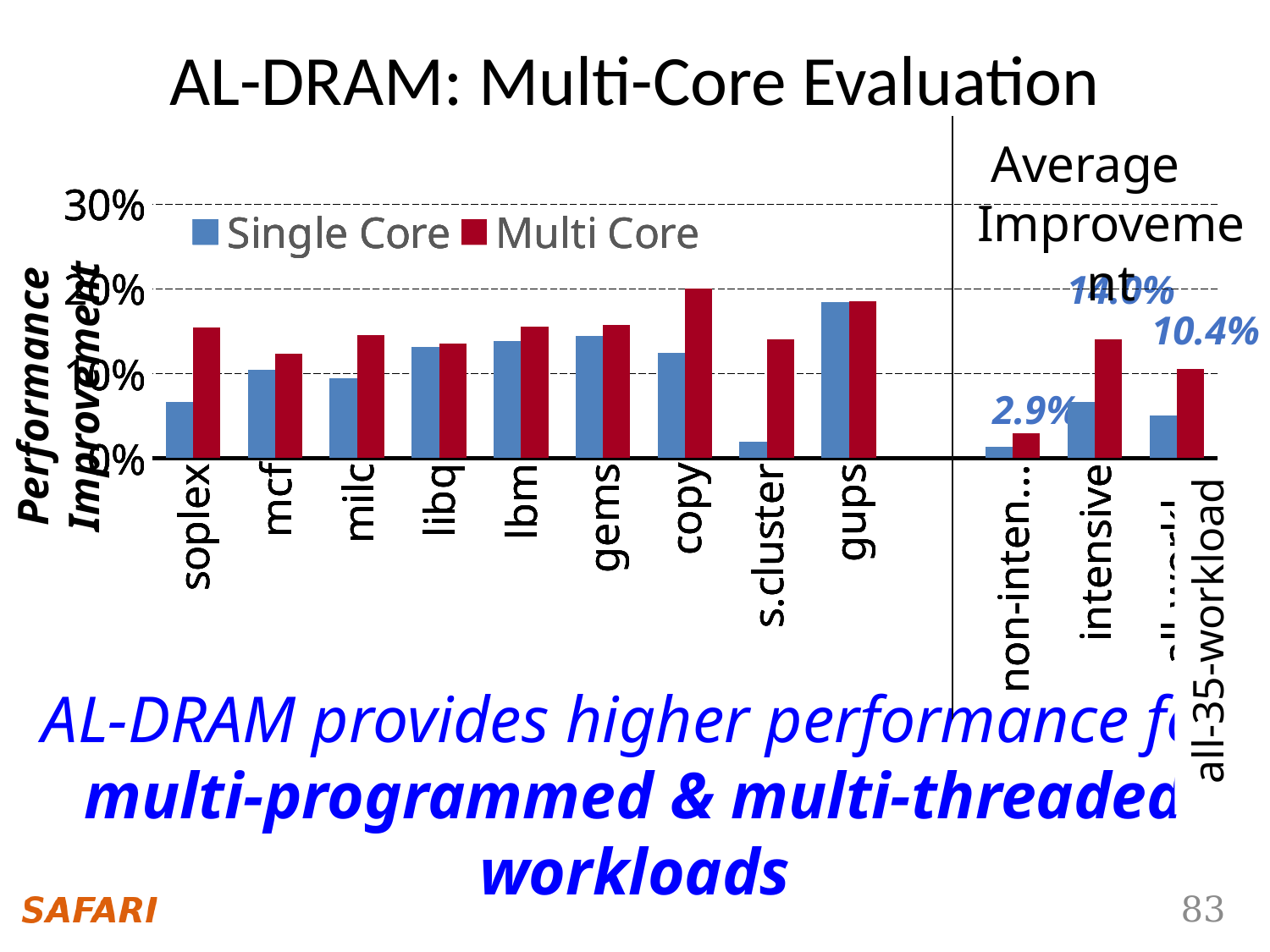
What are the two series named in the legend? Single Core and Multi Core Which category has the highest Multi Core bar? copy Is the Single Core value for gups greater or less than 10%? greater What average improvement value is printed above the non-inten... group? 2.9% What colour are the Multi Core bars? red How many benchmark categories are plotted to the left of the vertical divider line? 9 How many series does the legend list? 2 Is the Single Core value for s.cluster greater or less than 10%? less Which category has the lowest Multi Core bar? non-inten... For soplex, which is larger: the Single Core or the Multi Core value? Multi Core Which category has the highest Single Core bar? gups What kind of chart is shown on the slide? bar chart